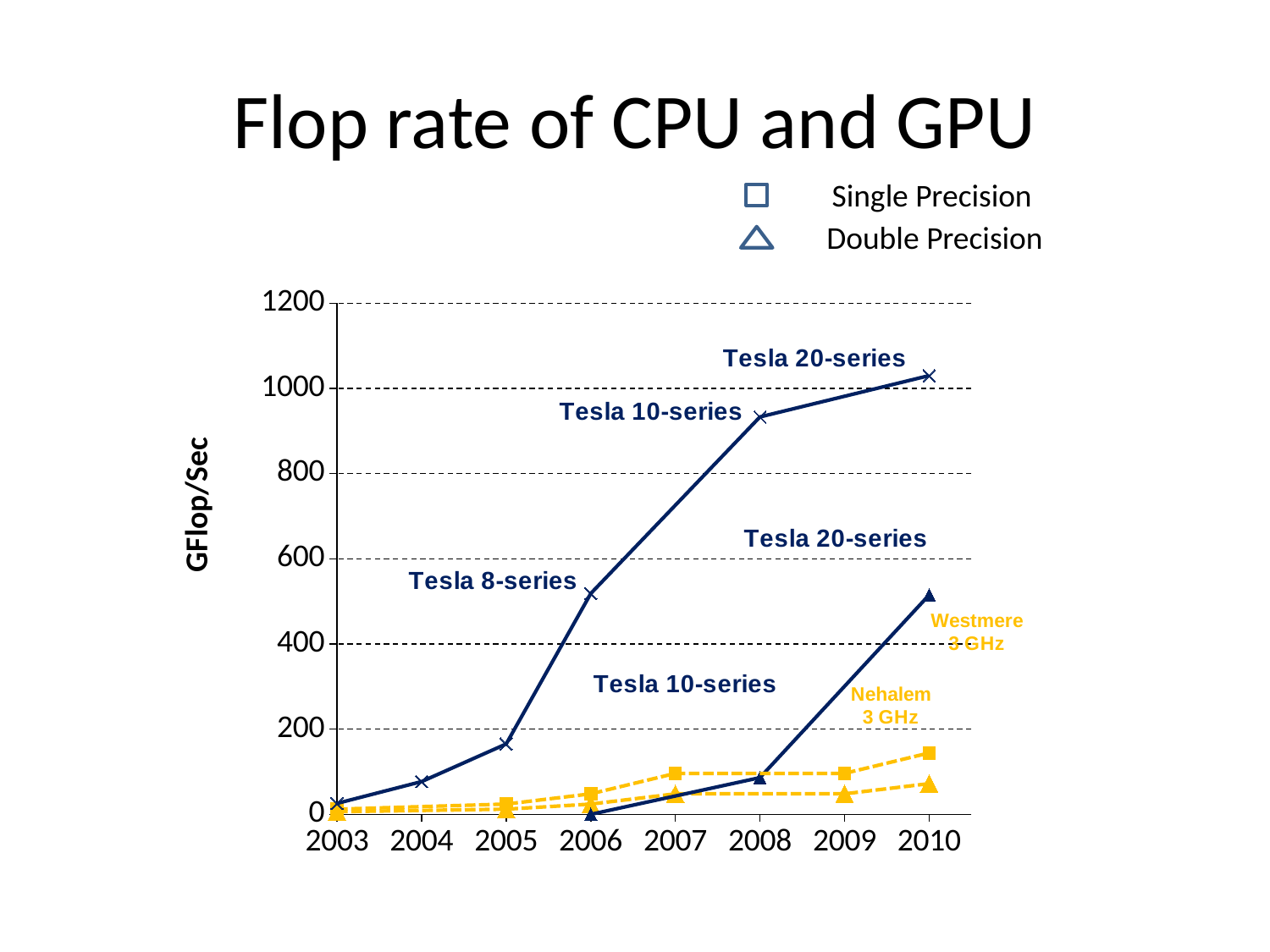
Is the GPU single precision value (Tesla 8-series) in 2006 greater or less than 600? less How many years are shown along the x axis? 8 Does the GPU single precision line rise or fall from 2003 to 2010? rise In 2010, which is higher: the GPU single precision value or the GPU double precision value? GPU single precision What is the label on the y axis? GFlop/Sec Is the GPU double precision value (Tesla 10-series) in 2008 greater or less than 200? less Which marker shape does the legend use for Double Precision? triangle Is the GPU single precision value (Tesla 20-series) in 2010 greater or less than 800? greater What kind of chart is shown on the slide? line chart